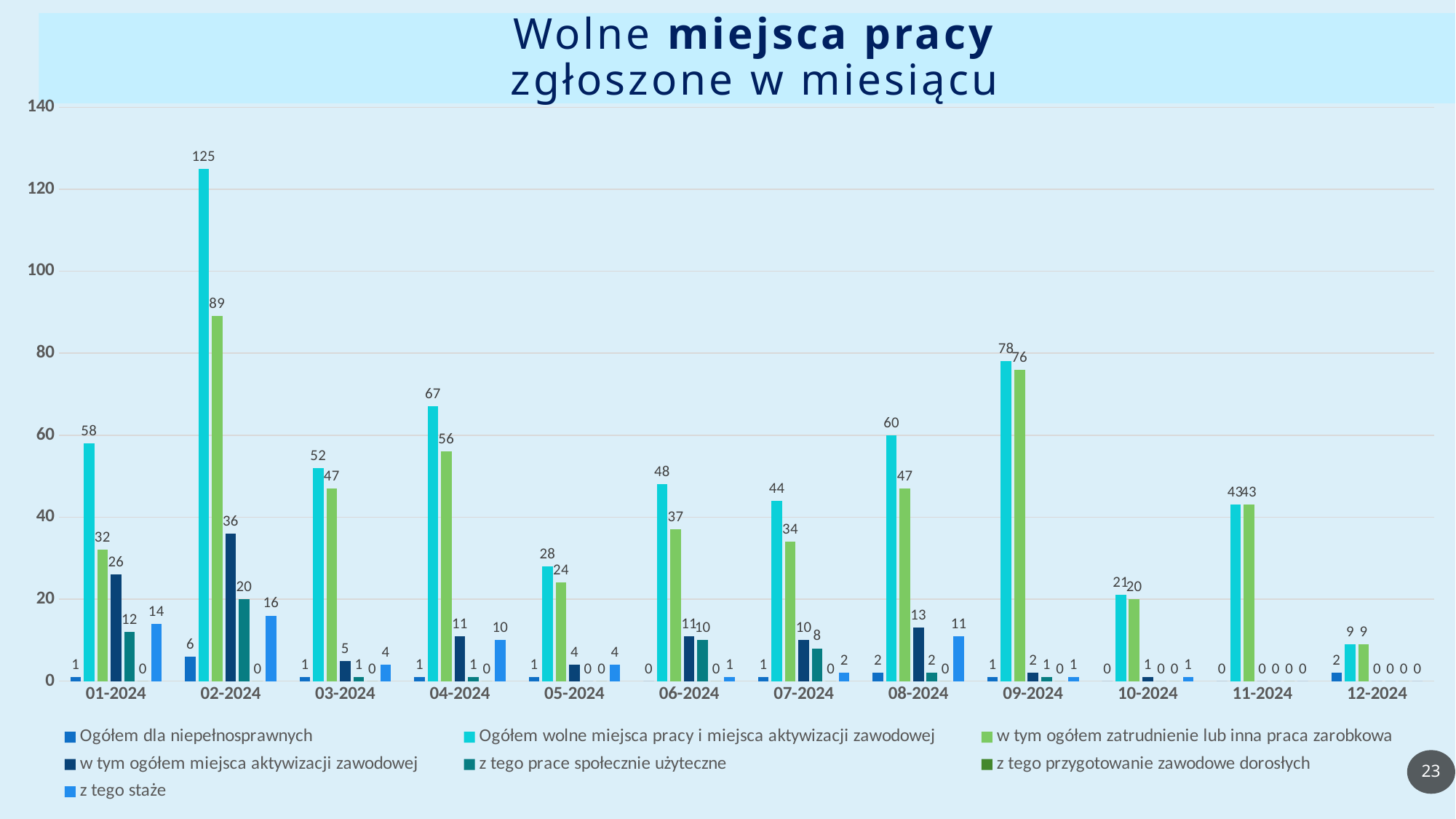
In which month is 'Ogółem wolne miejsca pracy i miejsca aktywizacji zawodowej' lowest? 12-2024 What is the value of 'z tego staże' for 08-2024? 11 What is the difference between 'Ogółem wolne miejsca pracy i miejsca aktywizacji zawodowej' and 'w tym ogółem zatrudnienie lub inna praca zarobkowa' in 02-2024? 36 Which is larger: 'w tym ogółem miejsca aktywizacji zawodowej' in 01-2024 or in 08-2024? 01-2024 In which month is 'Ogółem wolne miejsca pracy i miejsca aktywizacji zawodowej' highest? 02-2024 How many series does the legend list? 7 What is the value of 'Ogółem wolne miejsca pracy i miejsca aktywizacji zawodowej' for 02-2024? 125 Is the value of 'Ogółem wolne miejsca pracy i miejsca aktywizacji zawodowej' for 04-2024 greater or less than 60? greater What is the value of 'w tym ogółem zatrudnienie lub inna praca zarobkowa' for 09-2024? 76 What is the title of the chart? Wolne miejsca pracy zgłoszone w miesiącu How many months are shown on the x axis? 12 What kind of chart is shown on the slide? bar chart